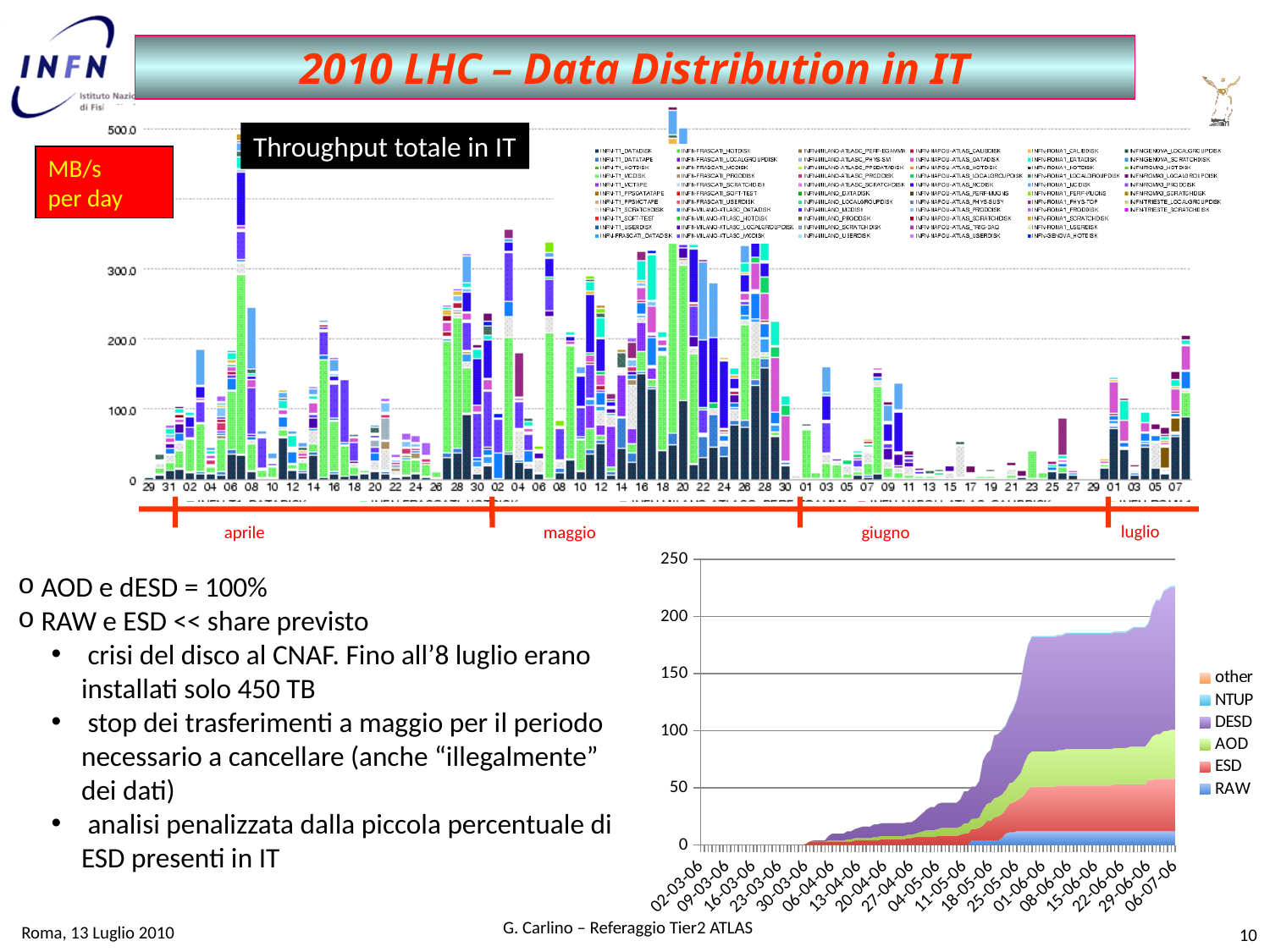
How many series does the legend of the bottom-right chart list? 6 In the top chart, is the value for 06 aprile greater or less than 300? greater In the bottom-right chart, is the total value at 06-07-06 greater or less than 200? greater In the bottom-right chart, is the total value at 02-03-06 greater or less than 50? less Which series is listed first in the legend of the bottom-right chart? other What kind of chart is the top chart (Throughput totale in IT)? bar chart What kind of chart is the bottom-right chart? area chart What is the title shown on the top chart? Throughput totale in IT In the bottom-right chart, do the values rise or fall along the x axis from 02-03-06 to 06-07-06? rise In the bottom-right chart, which series has the largest band at the end of the period (06-07-06)? DESD